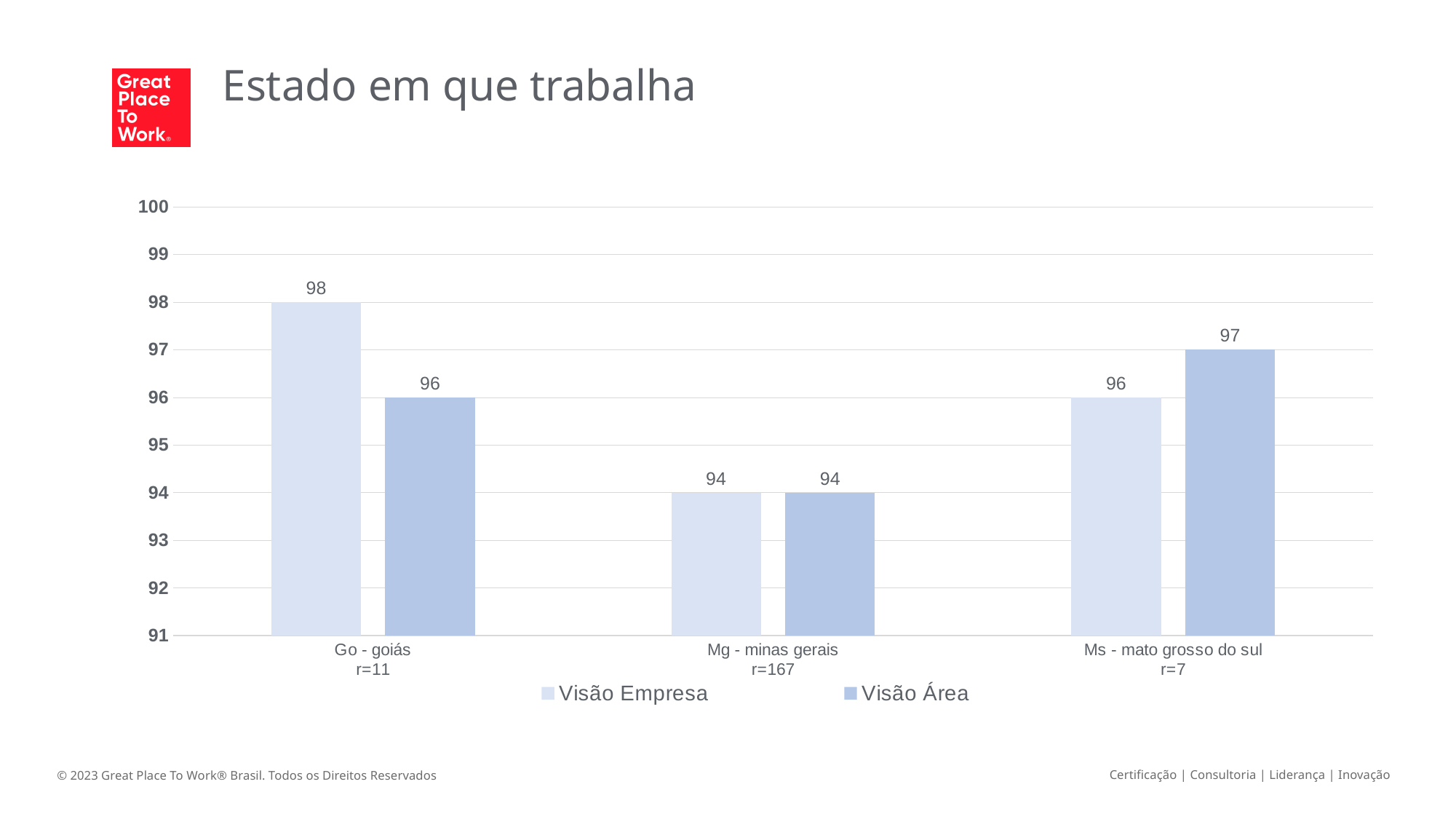
What is the difference between the Visão Empresa and Visão Área values for Go - goiás? 2 What is the sample size (r) shown for Mg - minas gerais? r=167 Which state has the lowest Visão Área value? Mg - minas gerais Which is larger for Ms - mato grosso do sul: Visão Empresa or Visão Área? Visão Área What kind of chart is shown on the slide? Bar chart Which state has the highest Visão Empresa value? Go - goiás What is the Visão Área value for Mg - minas gerais? 94 How many states are shown on the x axis? 3 What is the title of the slide? Estado em que trabalha What is the Visão Empresa value for Go - goiás? 98 How many series does the legend list? 2 What is the Visão Área value for Ms - mato grosso do sul? 97